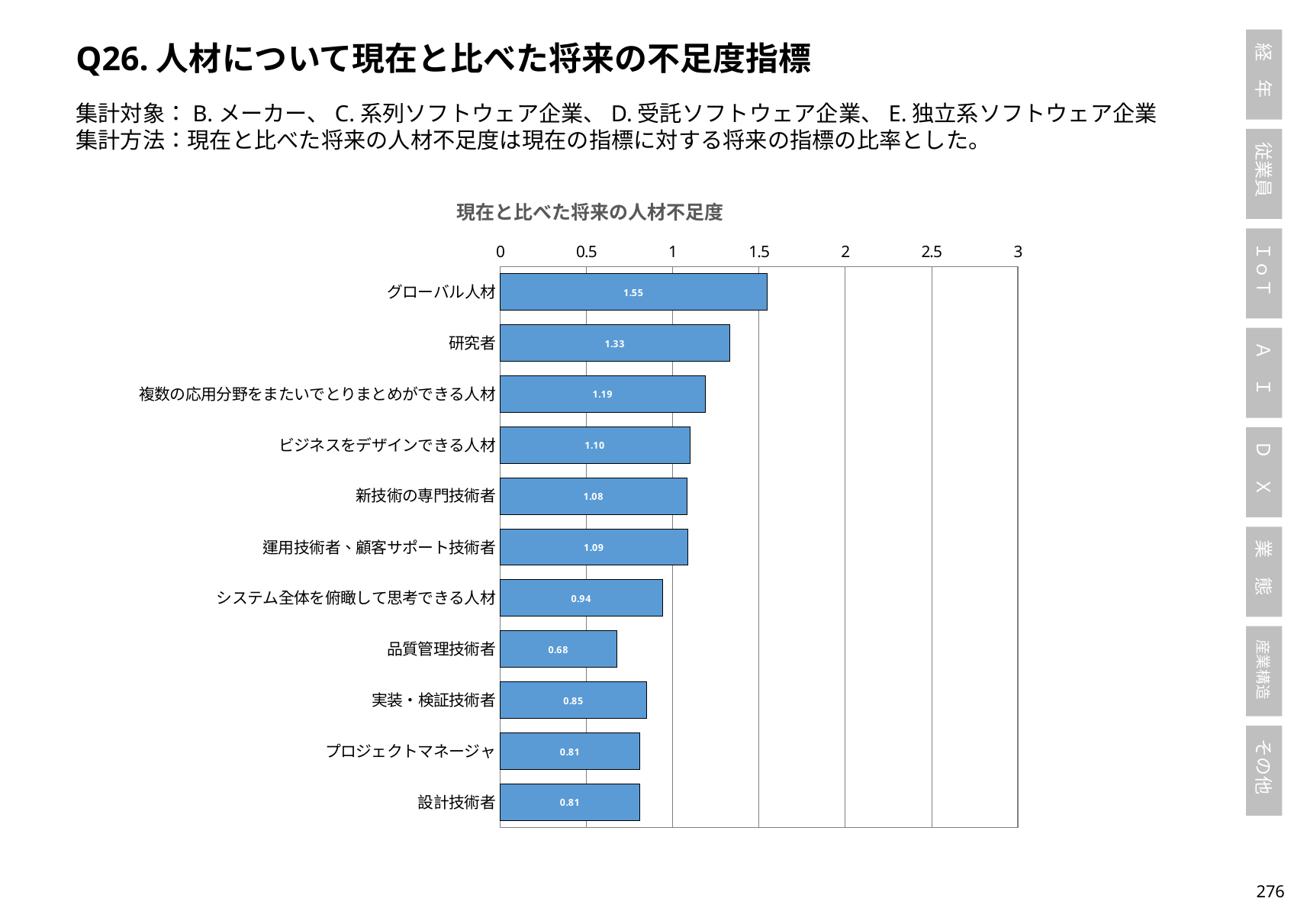
Which category has the lowest value? 品質管理技術者 Is the value for 複数の応用分野をまたいでとりまとめができる人材 greater or less than 1? greater Which is larger, the value for 実装・検証技術者 or the value for プロジェクトマネージャ? 実装・検証技術者 What is the difference between the values for グローバル人材 and 研究者? 0.22 What is the value for 研究者? 1.33 What is the value for システム全体を俯瞰して思考できる人材? 0.94 What is the title of the chart? 現在と比べた将来の人材不足度 What is the value for 品質管理技術者? 0.68 What kind of chart is shown? bar chart What is the value for グローバル人材? 1.55 How many categories are shown in the chart? 11 Which category has the highest value? グローバル人材